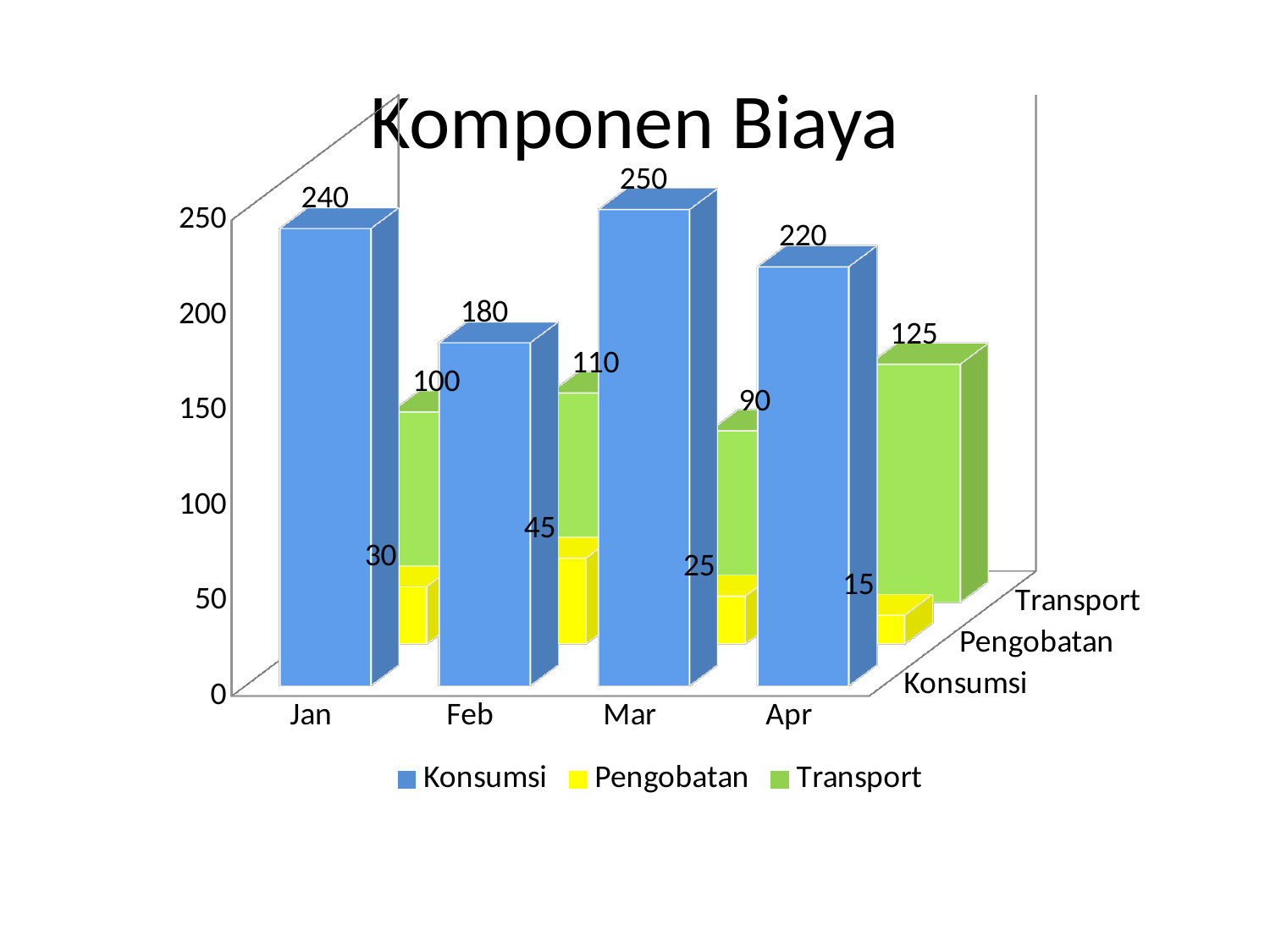
Which is larger, the Transport value for Feb or the Transport value for Mar? Feb Which month has the highest Konsumsi value? Mar What is the Konsumsi value for Jan? 240 How many series does the legend list? 3 What is the title of the chart? Komponen Biaya Which month has the lowest Pengobatan value? Apr What is the Pengobatan value for Feb? 45 What is the Transport value for Apr? 125 What is the difference between the Konsumsi values for Mar and Feb? 70 Is the Konsumsi value for Apr greater or less than 200? greater How many months are shown on the x axis? 4 What kind of chart is shown on the slide? bar chart